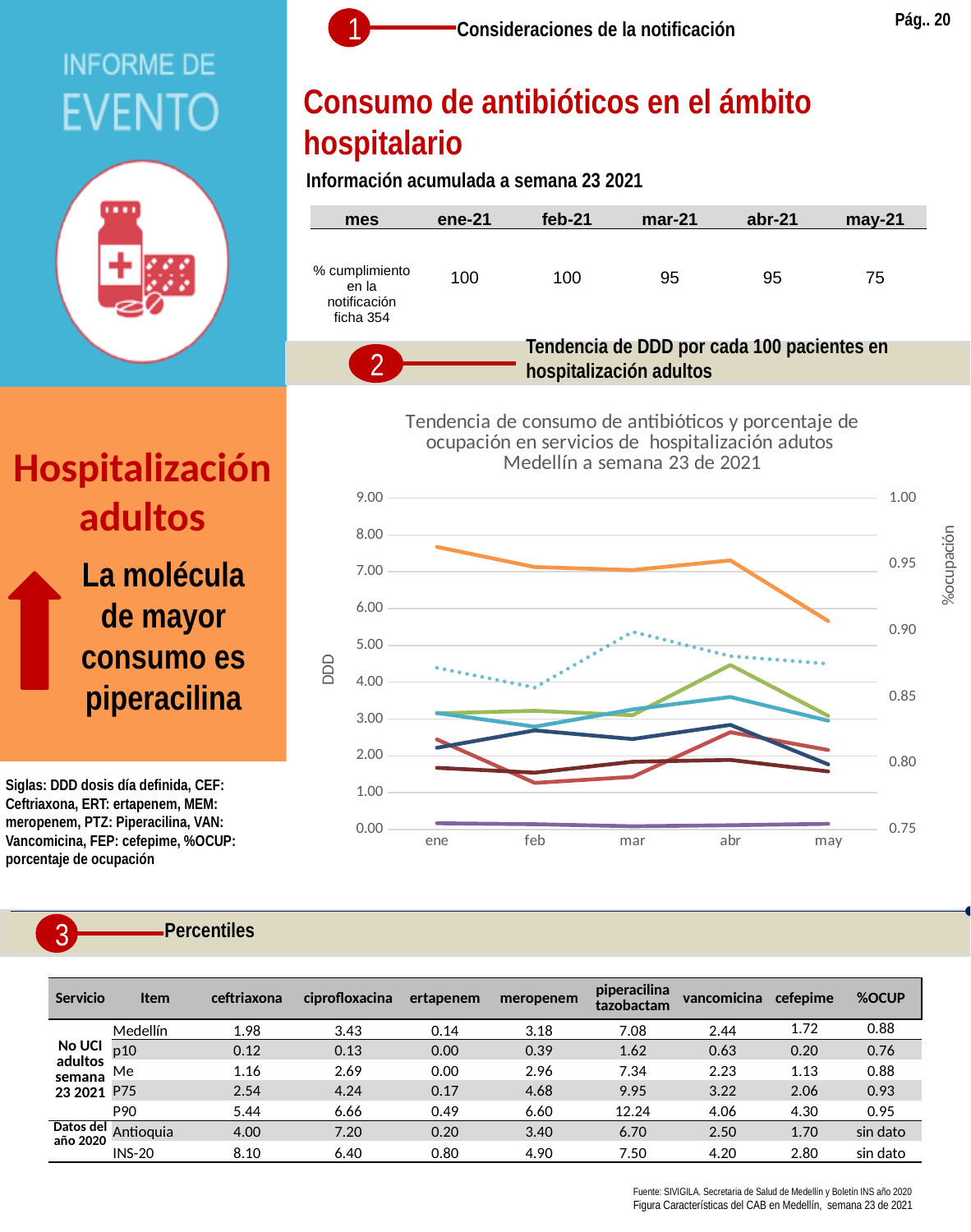
In which month does the orange line reach its highest value? ene How many months are plotted along the x axis of the chart? 5 What is the title of the right vertical axis of the chart? %ocupación In which month does the orange line reach its lowest value? may Is the value of the green line at abr greater or less than 4.00? greater What is the title of the left vertical axis of the chart? DDD What kind of chart is shown on the slide? line chart Is the value of the orange line at may greater or less than 6.00? less Is the value of the orange line at ene greater or less than 7.00? greater Does the orange line in the chart rise or fall overall from ene to may? fall At ene, which line has the larger value on the left axis, the orange line or the green line? orange line In which month does the green line reach its highest value? abr